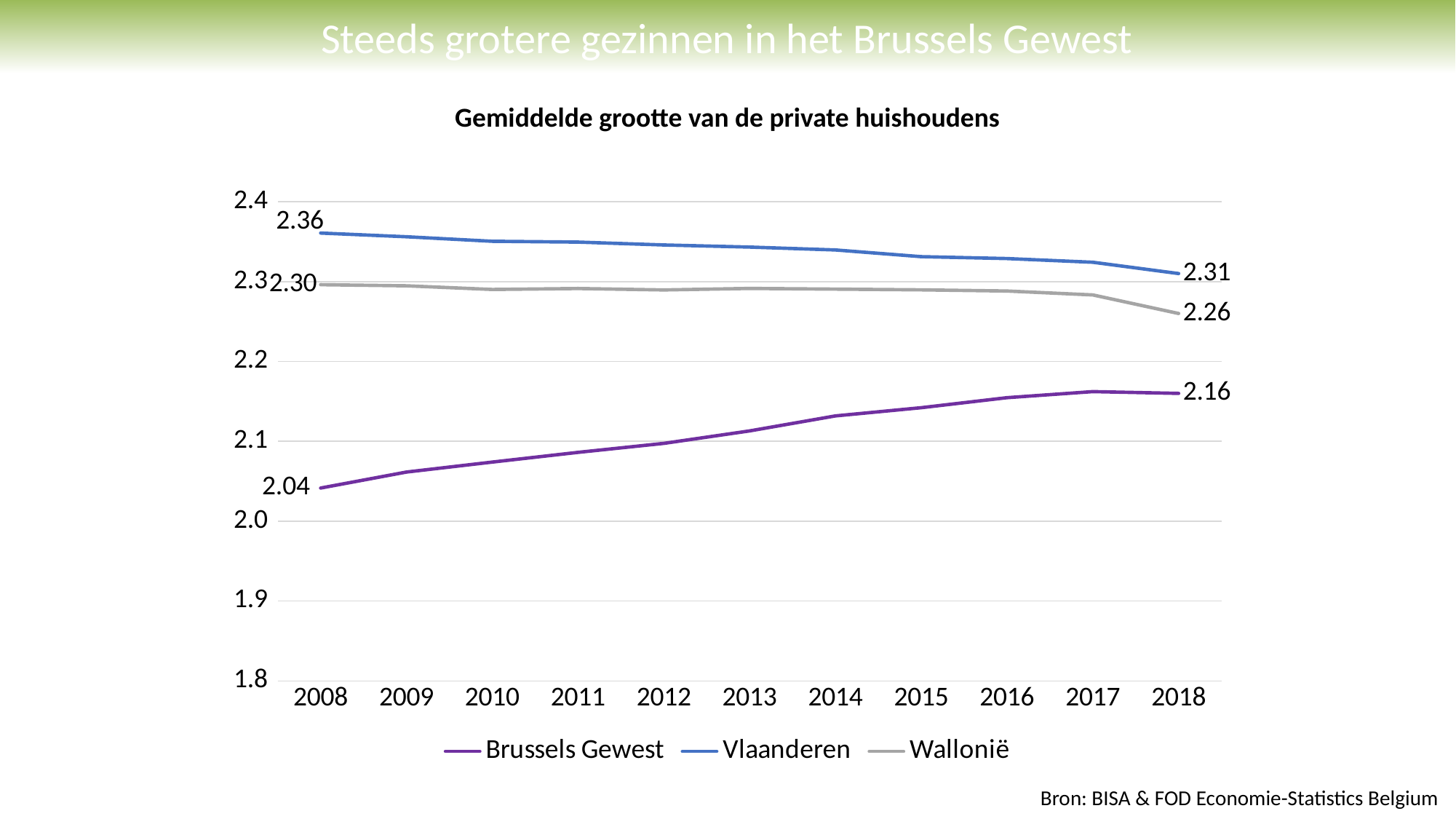
Which series has the lowest value in 2008? Brussels Gewest Is the value for Brussels Gewest in 2013 greater or less than 2.2? less Which is larger in 2018: the value for Wallonië or the value for Brussels Gewest? Wallonië What is the difference between the Brussels Gewest values in 2018 and 2008? 0.12 What is the value for Brussels Gewest in 2018? 2.16 What is the value for Wallonië in 2008? 2.30 What is the value for Brussels Gewest in 2008? 2.04 How many series does the legend list? 3 Which series has the highest value in 2018? Vlaanderen What is the value for Vlaanderen in 2018? 2.31 Does the value for Brussels Gewest rise or fall from 2008 to 2018? rise How many years are shown on the x axis? 11